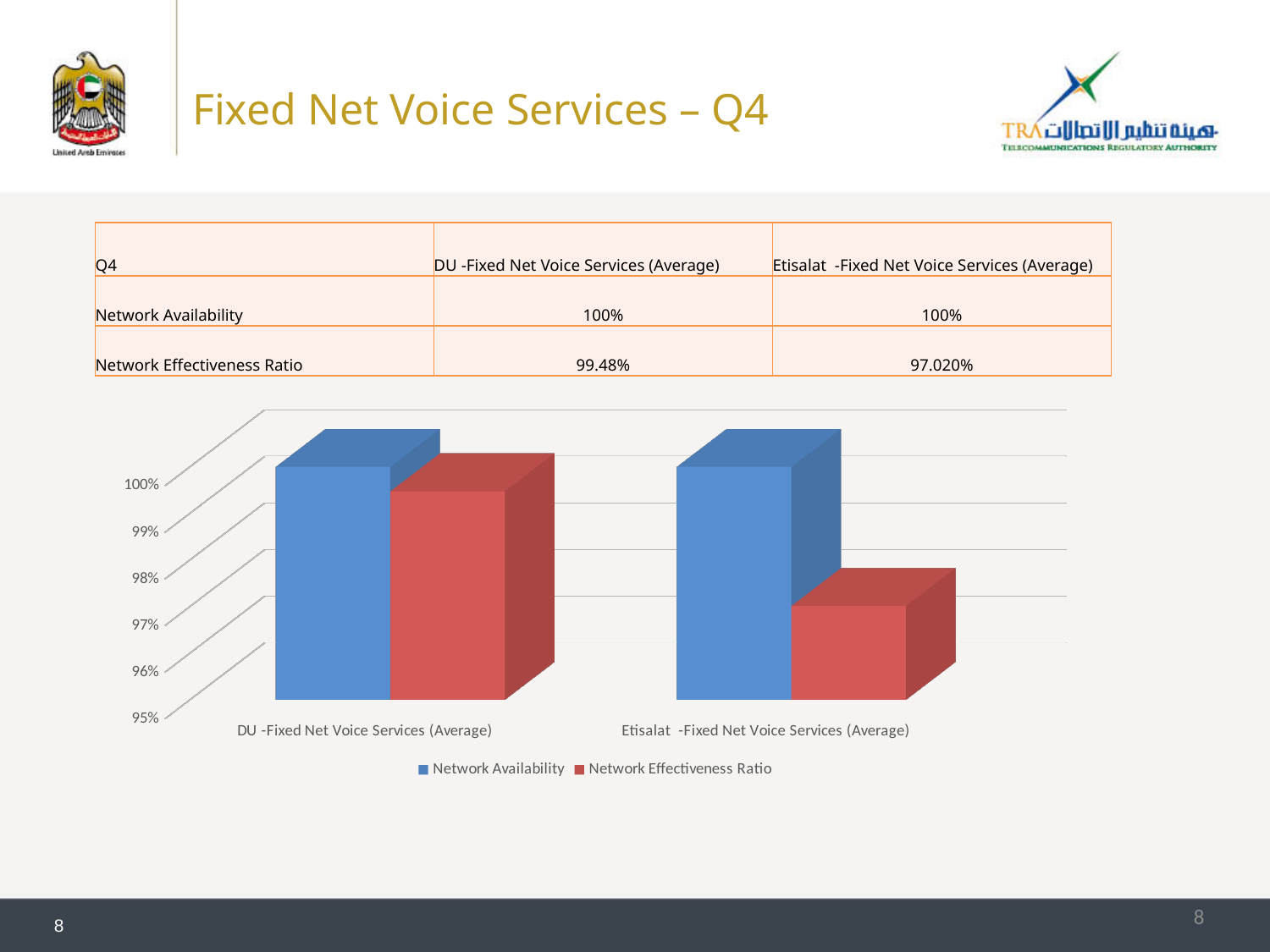
Which operator has the higher Network Effectiveness Ratio, DU or Etisalat? DU How many series does the chart legend list? 2 How many categories are shown on the x axis of the chart? 2 What kind of chart is shown on the slide? Bar chart What is the Network Effectiveness Ratio for DU - Fixed Net Voice Services (Average)? 99.48% What is the Network Availability for DU - Fixed Net Voice Services (Average)? 100% What is the Network Effectiveness Ratio for Etisalat - Fixed Net Voice Services (Average)? 97.020% Which operator has the lowest Network Effectiveness Ratio? Etisalat Is the Network Effectiveness Ratio for DU greater or less than 99%? greater Which colour represents Network Availability in the chart legend? Blue Is the Network Effectiveness Ratio for Etisalat greater or less than 98%? less What is the difference between the Network Effectiveness Ratio of DU and that of Etisalat? 2.46%